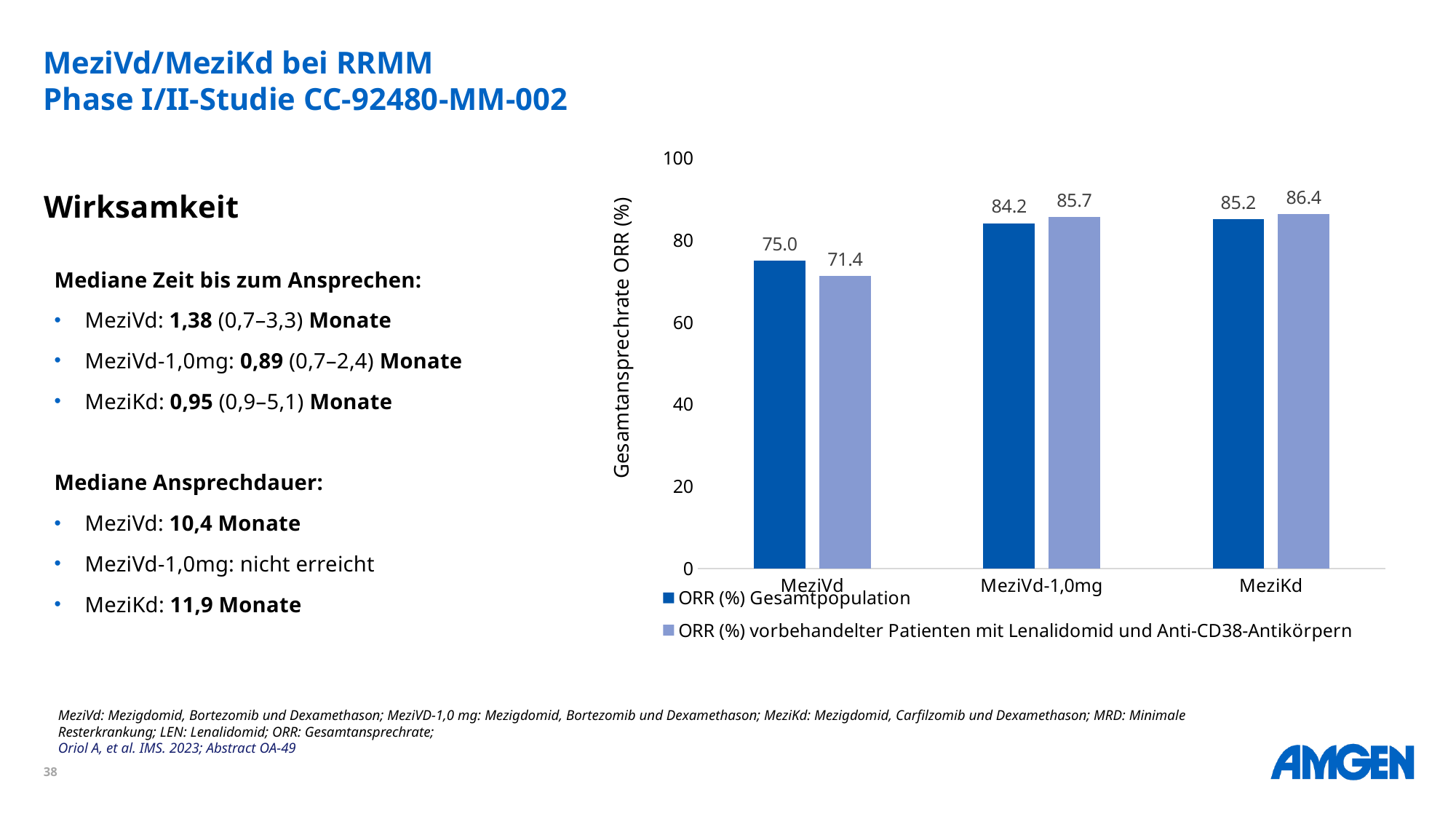
What kind of chart is shown on the slide? bar chart How many series does the chart legend list? 2 What is the ORR (%) Gesamtpopulation value for MeziVd? 75.0 How many categories are shown on the x axis of the chart? 3 Which category has the lowest ORR (%) vorbehandelter Patienten mit Lenalidomid und Anti-CD38-Antikörpern value? MeziVd What is the ORR (%) Gesamtpopulation value for MeziVd-1,0mg? 84.2 Is the ORR (%) Gesamtpopulation value for MeziVd-1,0mg greater or less than 80? greater For MeziVd, which is larger: ORR (%) Gesamtpopulation or ORR (%) vorbehandelter Patienten mit Lenalidomid und Anti-CD38-Antikörpern? ORR (%) Gesamtpopulation What is the label of the y axis of the chart? Gesamtansprechrate ORR (%) What is the ORR (%) vorbehandelter Patienten mit Lenalidomid und Anti-CD38-Antikörpern value for MeziKd? 86.4 What is the difference between the ORR (%) Gesamtpopulation value for MeziKd and for MeziVd? 10.2 Which category has the highest ORR (%) Gesamtpopulation value? MeziKd